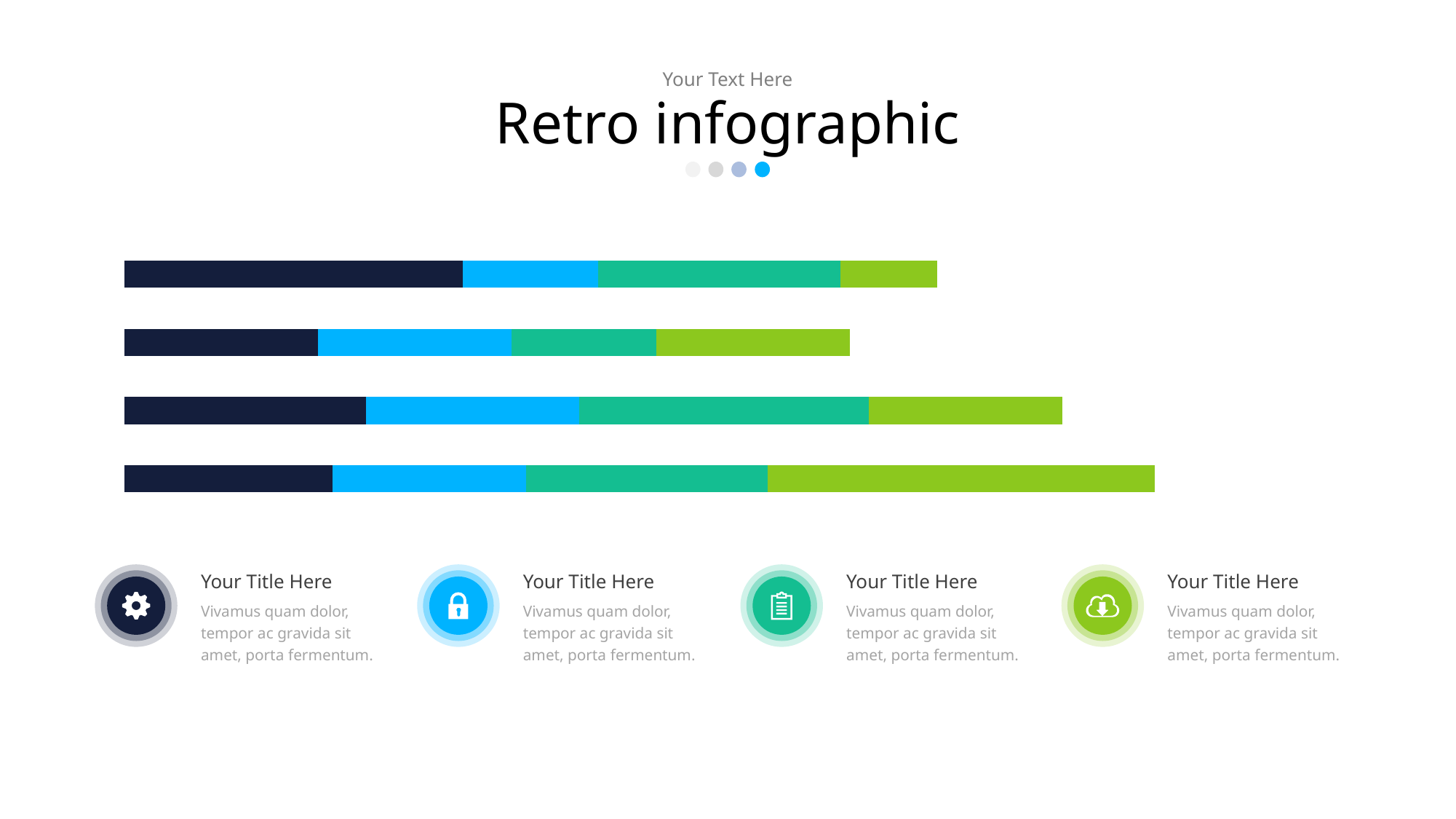
Which bar has the longest dark navy (leftmost) segment? The top bar How many bars does the chart contain? 4 Which bar has the longest green (rightmost) segment? The bottom bar How many coloured segments make up each bar in the chart? 4 Which is longer overall, the third bar from the top or the bottom bar? The bottom bar Which bar in the chart is the longest overall? The bottom bar What kind of chart is shown on the slide? Stacked bar chart Are the bars in the chart oriented horizontally or vertically? Horizontally Which bar in the chart is the shortest overall? The second bar from the top Which is longer overall, the top bar or the second bar from the top? The top bar What colour is the leftmost segment of each bar? Dark navy